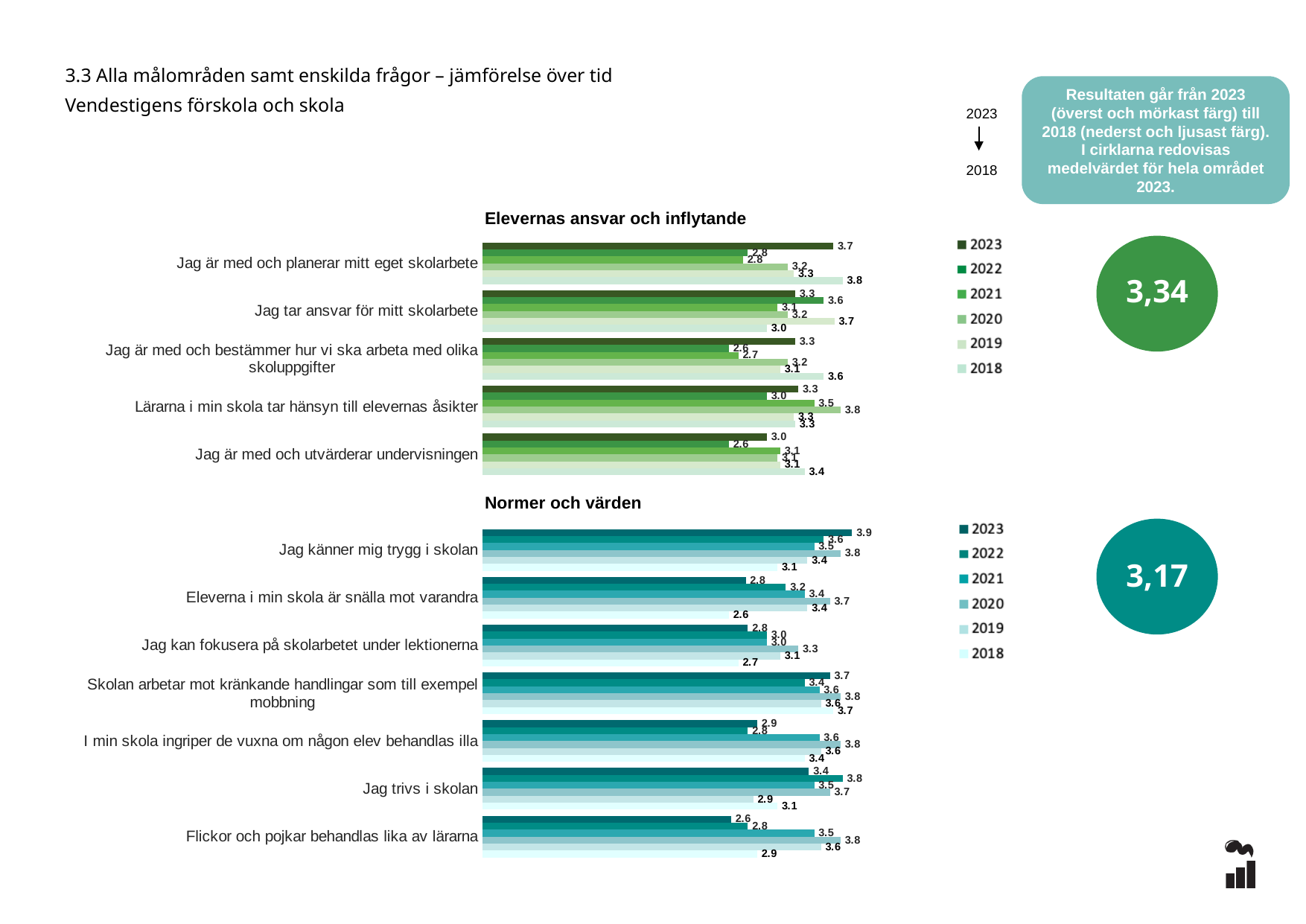
What is the 2023 mean value shown in the circle for the 'Normer och värden' area? 3,17 In the 'Normer och värden' chart, what is the 2018 value for 'Eleverna i min skola är snälla mot varandra'? 2.6 In the 'Elevernas ansvar och inflytande' chart, which question has the highest 2023 value? Jag är med och planerar mitt eget skolarbete How many series does the legend of the 'Elevernas ansvar och inflytande' chart list? 6 In the 'Elevernas ansvar och inflytande' chart, what is the difference between the 2023 and 2022 values for 'Jag är med och planerar mitt eget skolarbete'? 0.9 In the 'Elevernas ansvar och inflytande' chart, what is the 2023 value for 'Jag är med och planerar mitt eget skolarbete'? 3.7 In the 'Normer och värden' chart, what is the 2023 value for 'Jag känner mig trygg i skolan'? 3.9 In the 'Normer och värden' chart, which question has the lowest 2023 value? Flickor och pojkar behandlas lika av lärarna What type of chart is used for 'Normer och värden'? Bar chart In the 'Normer och värden' chart, which is larger for 'Jag trivs i skolan': the 2023 value or the 2022 value? 2022 How many questions (categories) are shown in the 'Normer och värden' chart? 7 What is the 2023 mean value shown in the circle for the 'Elevernas ansvar och inflytande' area? 3,34